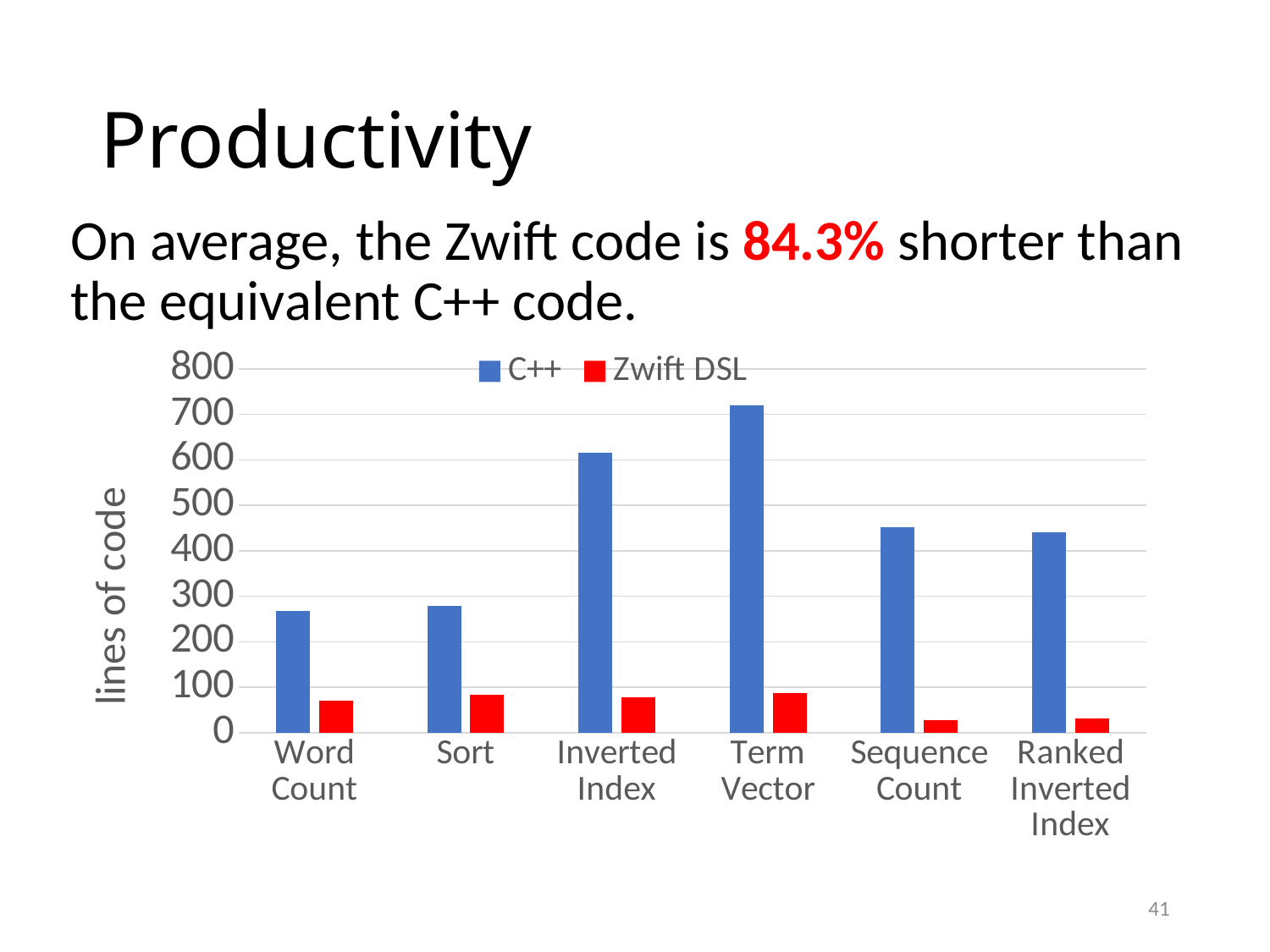
Which is larger, the C++ value for Inverted Index or the C++ value for Sequence Count? Inverted Index How many series does the chart legend list? 2 Which category has the highest C++ value? Term Vector How many categories are shown on the x axis of the chart? 6 Is the C++ value for Term Vector greater or less than 600? greater What is the label of the y axis of the chart? lines of code Which is larger, the Zwift DSL value for Word Count or the Zwift DSL value for Sequence Count? Word Count Is the C++ value for Inverted Index greater or less than 500? greater Is the C++ value for Sequence Count greater or less than 500? less What kind of chart is shown on the slide? bar chart